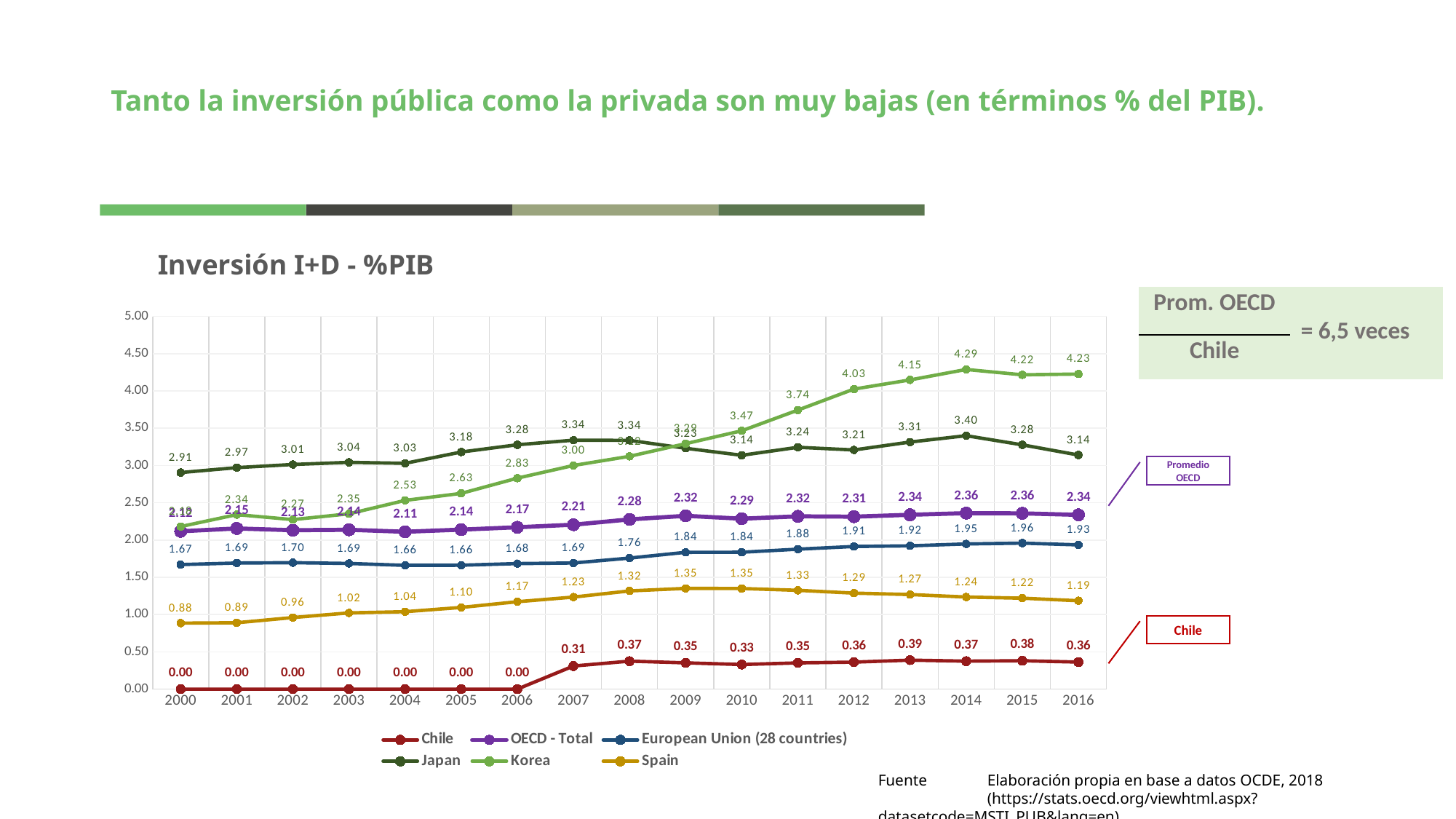
Does the value for Korea rise or fall from 2004 to 2014? Rise Which series has the lowest value in 2016? Chile What is the value for Korea in 2014? 4.29 What is the difference between Japan's value and the OECD - Total value in 2016? 0.80 How many series does the chart legend list? 6 What is the title of the chart? Inversión I+D - %PIB In 2010, which is larger: the value for Korea or the value for Japan? Korea How many years are plotted along the x axis of the chart? 17 Which series has the highest value in 2016? Korea What type of chart is shown on the slide? Line chart What is the value for Chile in 2013? 0.39 What is the value for Spain in 2009? 1.35